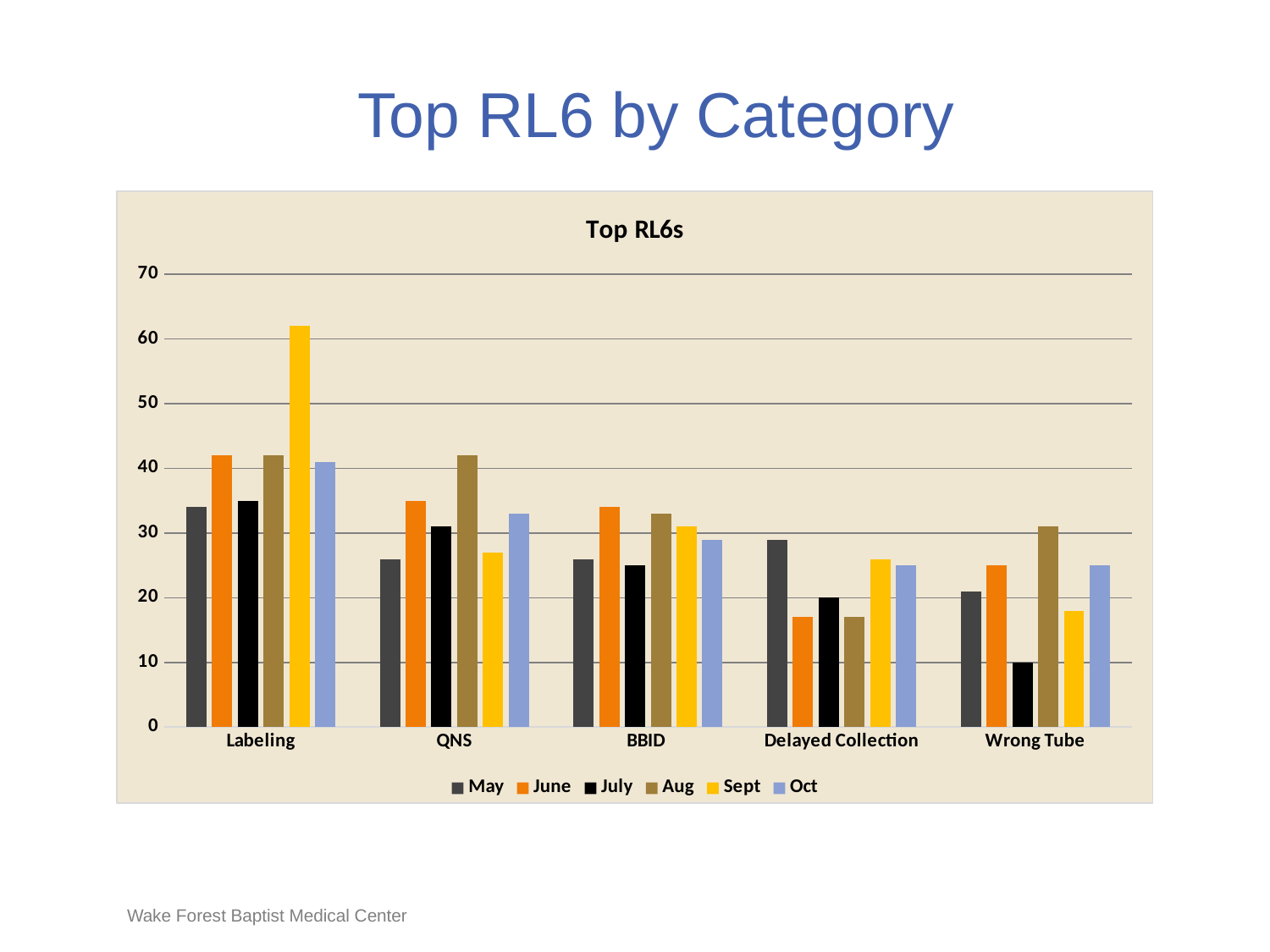
How many categories are shown on the x axis? 5 Is the value for Sept in the Labeling category greater or less than 60? greater Which month has the lowest value for Wrong Tube? July Which month has the highest value for QNS? Aug Is the value for June in the Delayed Collection category greater or less than 20? less What kind of chart is shown on the slide? bar chart How many series does the legend list? 6 Which is larger: the Sept value for Labeling or the Aug value for QNS? Sept value for Labeling What is the title shown inside the chart area? Top RL6s Is the value for Aug in the QNS category greater or less than 40? greater Which is larger for Wrong Tube: the Aug value or the Sept value? Aug Which month has the highest value for Labeling? Sept